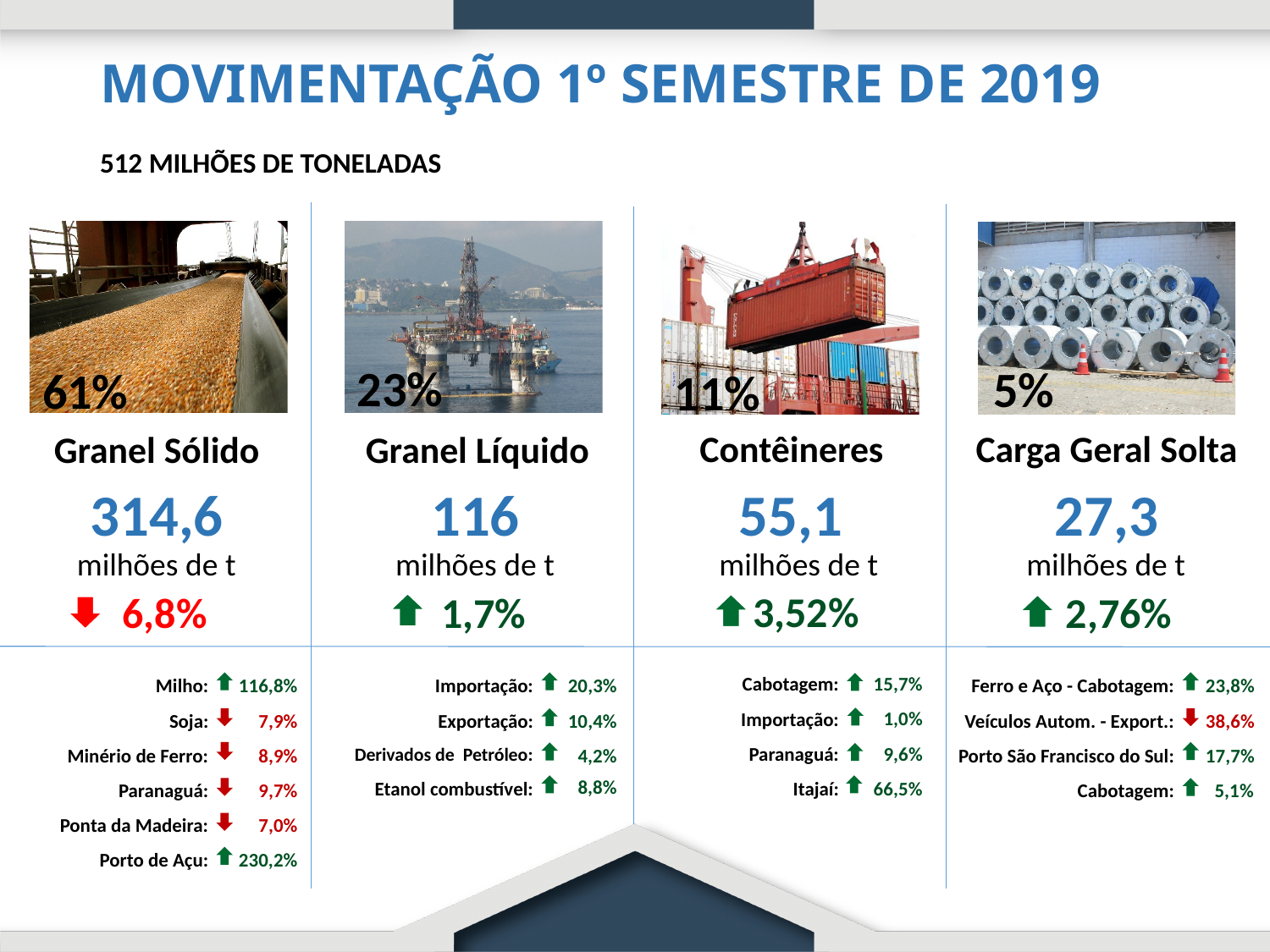
What is the percentage change shown for Contêineres? 3,52% increase Which cargo category shows a decrease compared with the previous period? Granel Sólido Which cargo category has the lowest tonnage? Carga Geral Solta Which has the larger tonnage, Contêineres or Carga Geral Solta? Contêineres What total tonnage is stated for the first semester of 2019? 512 milhões de toneladas What is the difference in tonnage between Granel Sólido and Granel Líquido? 198,6 milhões de t What share of the total movement does Granel Sólido represent? 61% What share of the total movement do Contêineres represent? 11% Which cargo category has the highest tonnage? Granel Sólido What is the percentage change shown for Porto de Açu under Granel Sólido? 230,2% increase How many millions of tonnes were moved as Granel Líquido? 116 milhões de t How many cargo categories are shown on the slide? 4